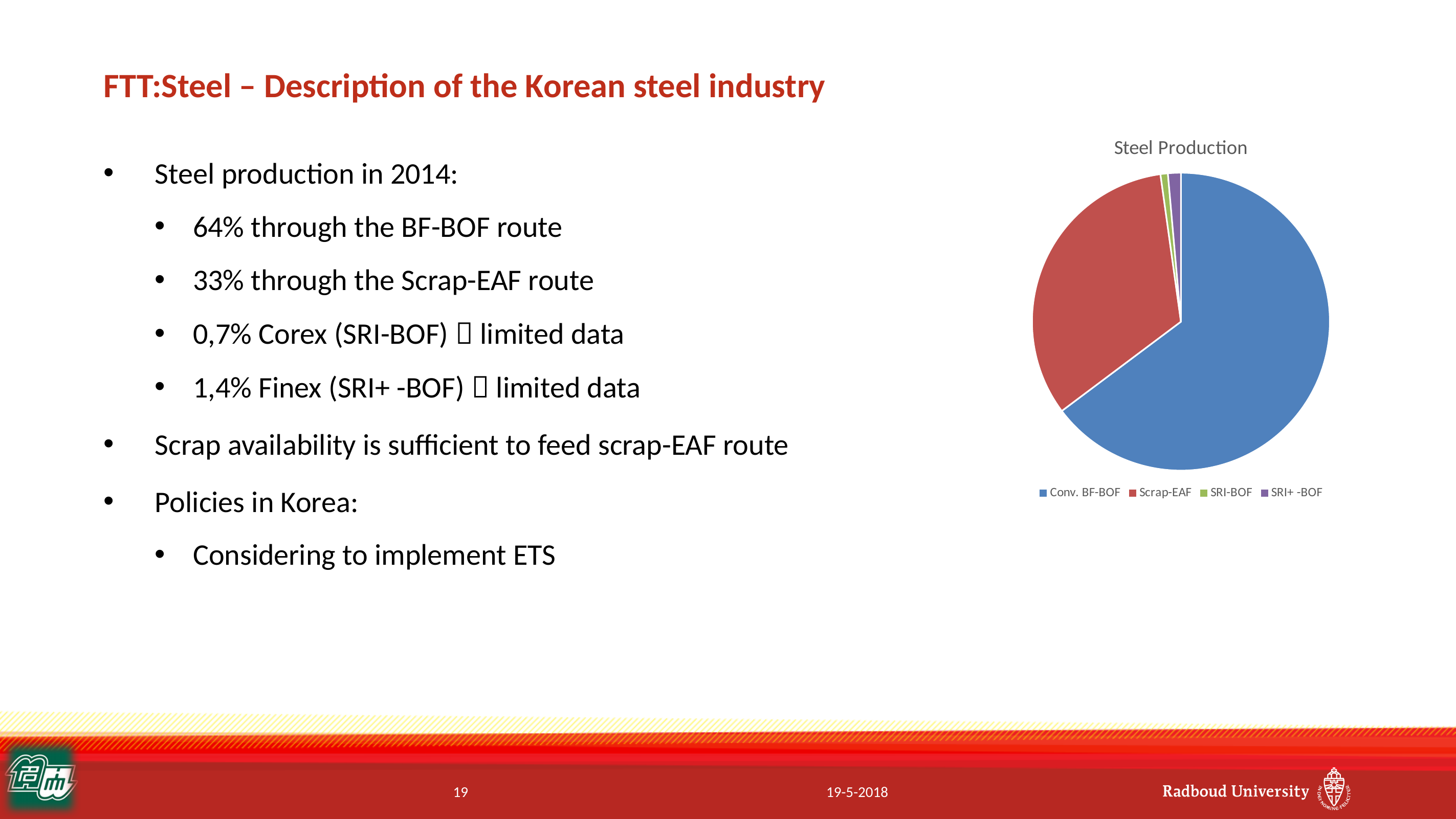
Which category has the smallest slice of the pie? SRI-BOF What is the title of the chart? Steel Production How many slices does the pie chart have? 4 Which slice is larger, SRI+ -BOF or SRI-BOF? SRI+ -BOF How many entries does the chart legend list? 4 Which slice is larger, Scrap-EAF or SRI+ -BOF? Scrap-EAF What kind of chart is shown on the slide? pie chart Which category has the largest slice of the pie? Conv. BF-BOF Which slice is larger, Conv. BF-BOF or Scrap-EAF? Conv. BF-BOF What colour is the Scrap-EAF slice in the pie chart? red